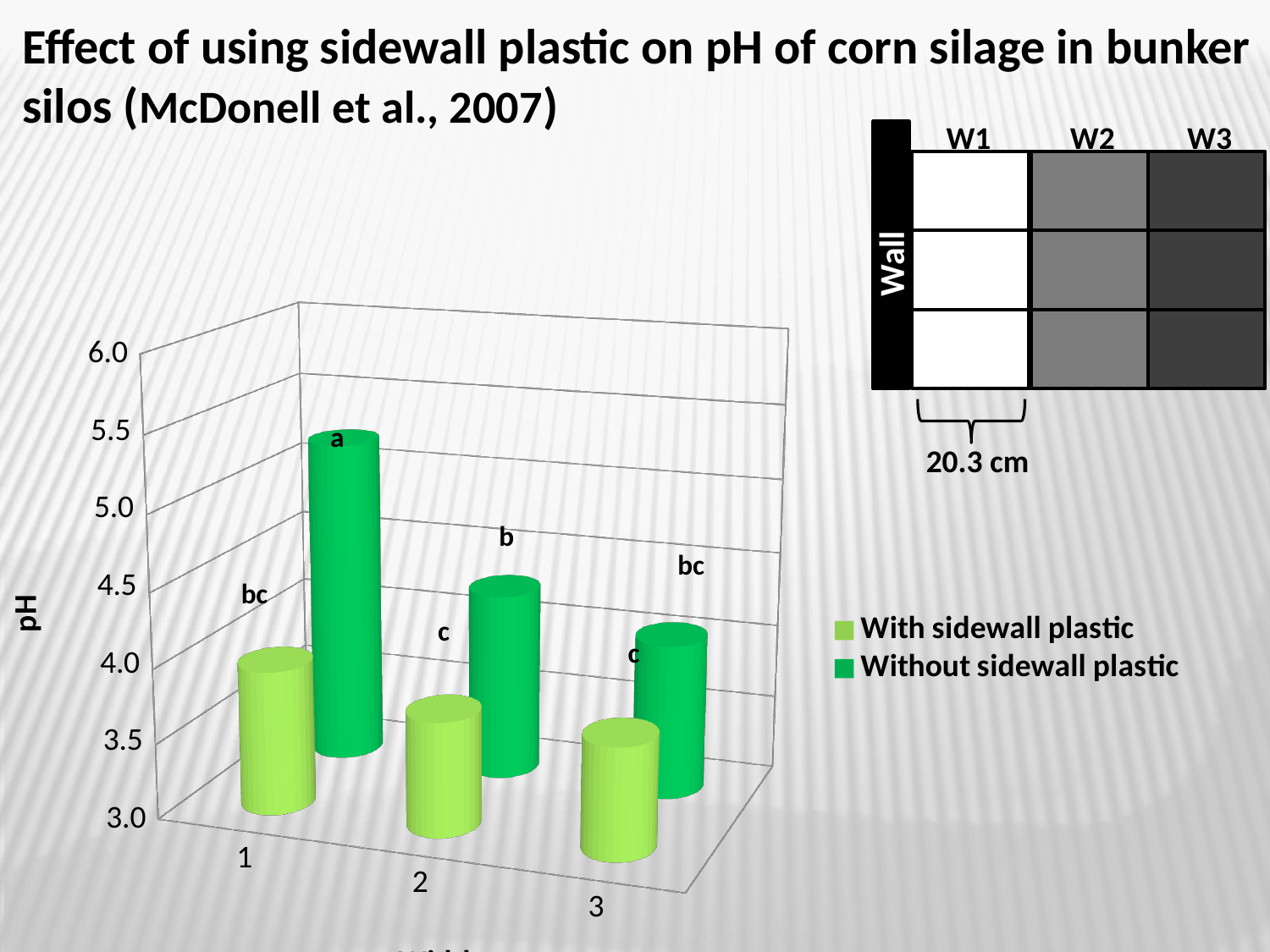
Is the pH value for Without sidewall plastic at width 3 greater or less than 4.5? less Is the pH value for Without sidewall plastic at width 1 greater or less than 5.0? greater How many width categories are shown on the x axis of the chart? 3 Which bar in the chart is the highest? Without sidewall plastic at width 1 What kind of chart is shown on the slide? bar chart How many series does the chart legend list? 2 At width 1, which series has the higher pH: With sidewall plastic or Without sidewall plastic? Without sidewall plastic Is the pH value for Without sidewall plastic at width 2 greater or less than 4.0? greater What is the label on the vertical axis of the chart? pH At width 3, which series has the higher pH: With sidewall plastic or Without sidewall plastic? Without sidewall plastic Do the pH values for Without sidewall plastic rise or fall from width 1 to width 3? fall